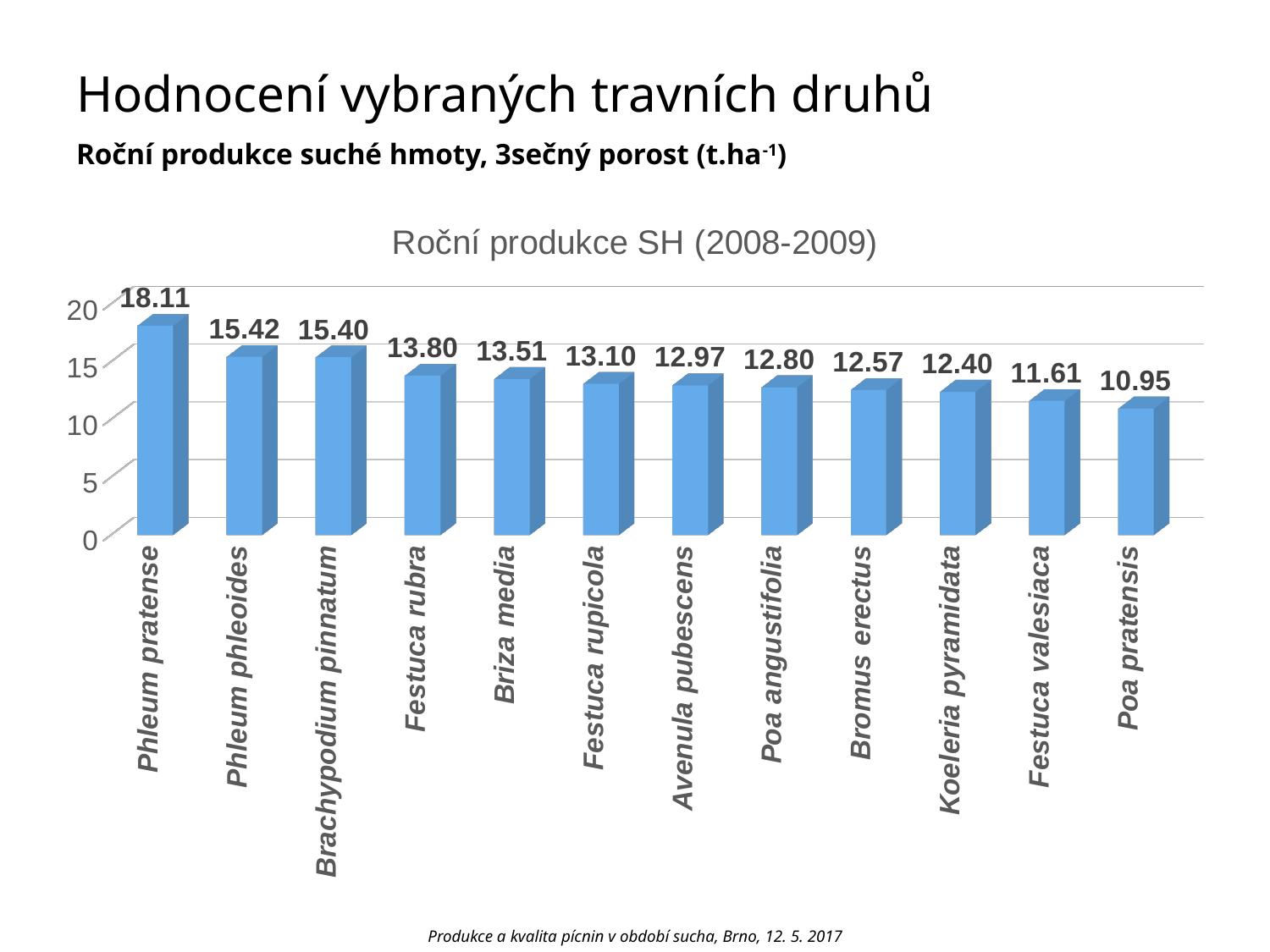
How many categories are shown in the chart? 12 What is the value for Koeleria pyramidata? 12.40 What is the value for Festuca rubra? 13.80 What kind of chart is shown on the slide? bar chart What is the difference between the values for Briza media and Festuca rupicola? 0.41 What is the value for Phleum pratense? 18.11 Which is larger, the value for Bromus erectus or the value for Festuca valesiaca? Bromus erectus What is the difference between the values for Phleum pratense and Poa pratensis? 7.16 What is the title of the chart? Roční produkce SH (2008-2009) Which category has the highest value? Phleum pratense Is the value for Phleum phleoides greater or less than 15? greater Which category has the lowest value? Poa pratensis